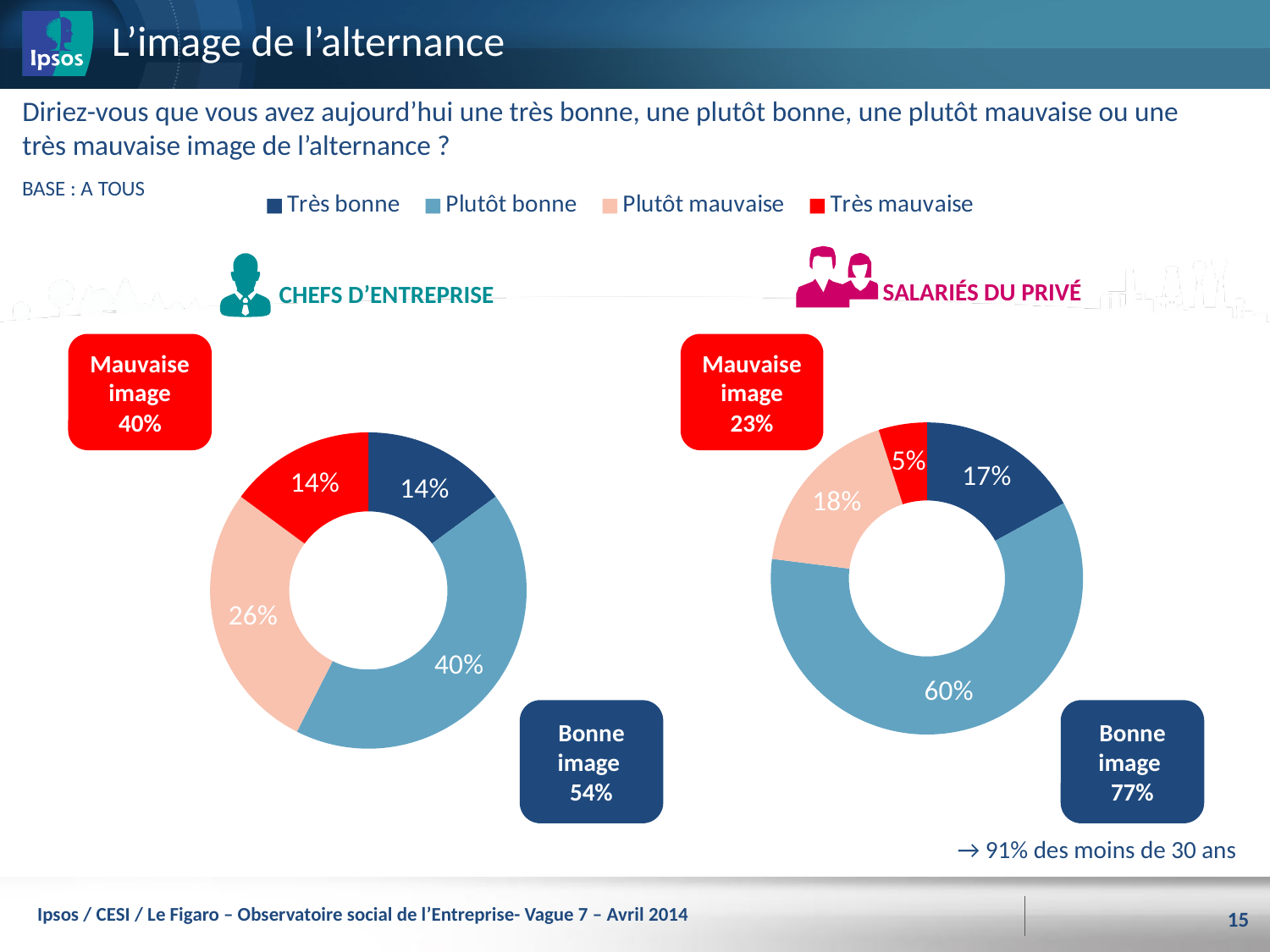
Which colour represents 'Très mauvaise' in the legend? Red What kind of chart is used for CHEFS D'ENTREPRISE? Doughnut (pie) chart In the CHEFS D'ENTREPRISE chart, what share is 'Plutôt bonne'? 40% In the CHEFS D'ENTREPRISE chart, what share is 'Plutôt mauvaise'? 26% In the SALARIÉS DU PRIVÉ chart, which category has the smallest share? Très mauvaise What is the difference between the 'Plutôt bonne' share in the SALARIÉS DU PRIVÉ chart and in the CHEFS D'ENTREPRISE chart? 20 percentage points Is the 'Plutôt mauvaise' share larger in the CHEFS D'ENTREPRISE chart or in the SALARIÉS DU PRIVÉ chart? CHEFS D'ENTREPRISE In the CHEFS D'ENTREPRISE chart, which category has the largest share? Plutôt bonne How many categories does the legend list? 4 In the SALARIÉS DU PRIVÉ chart, what share is 'Très mauvaise'? 5% In the SALARIÉS DU PRIVÉ chart, which category has the largest share? Plutôt bonne In the SALARIÉS DU PRIVÉ chart, what share is 'Très bonne'? 17%